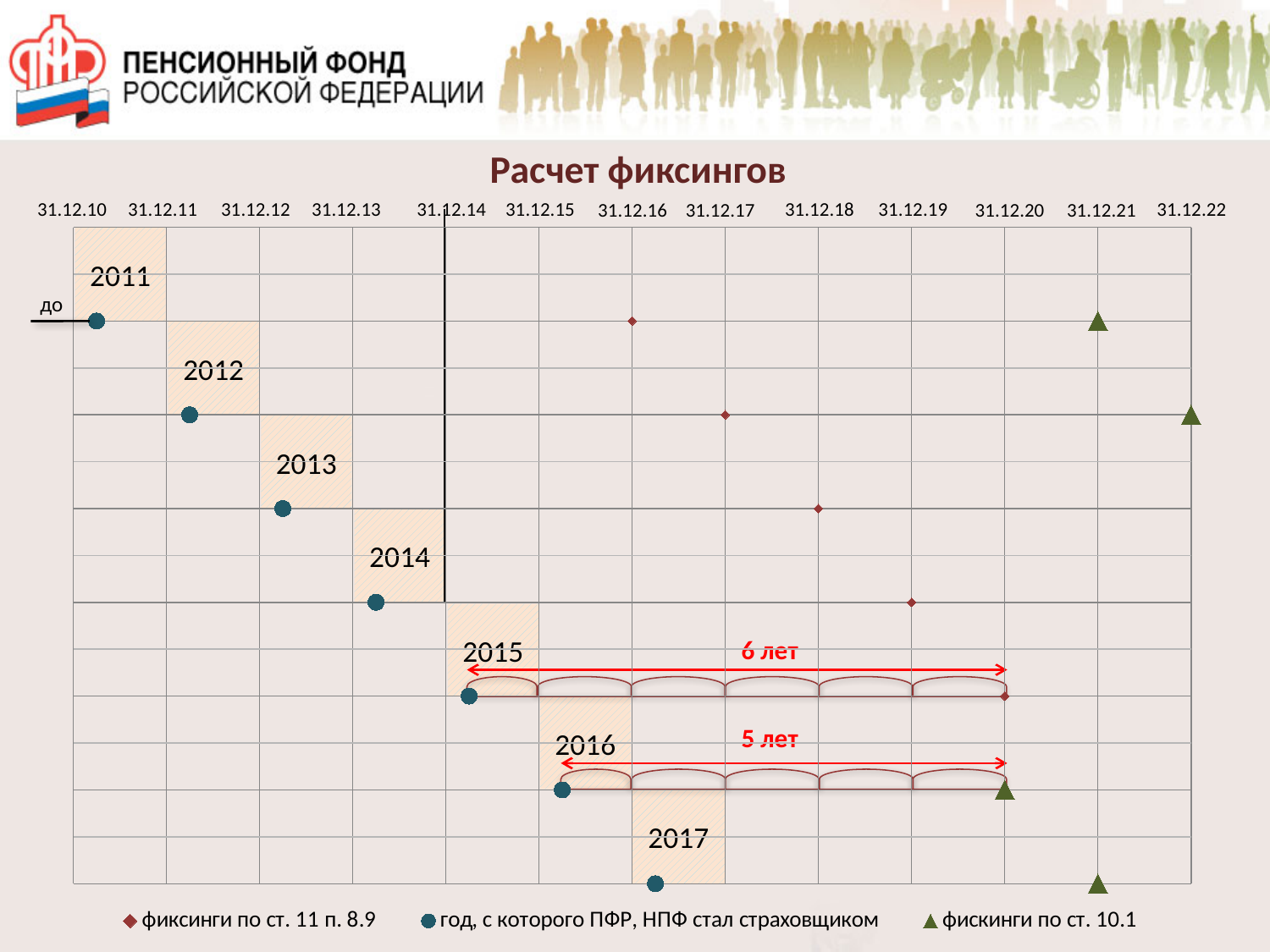
How many diamond markers (series 'фиксинги по ст. 11 п. 8.9') are plotted on the chart? 5 What is the title of the chart? Расчет фиксингов What is the first date tick on the x axis? 31.12.10 What duration label is written above the red arrow for 2016? 5 лет How many series does the legend list? 3 Which legend entry is shown with a triangle marker? фискинги по ст. 10.1 What duration label is written above the red arrow for 2015? 6 лет What is the last date tick on the x axis? 31.12.22 How many circle markers (series 'год, с которого ПФР, НПФ стал страховщиком') are plotted on the chart? 7 How many date ticks are shown along the x axis? 13